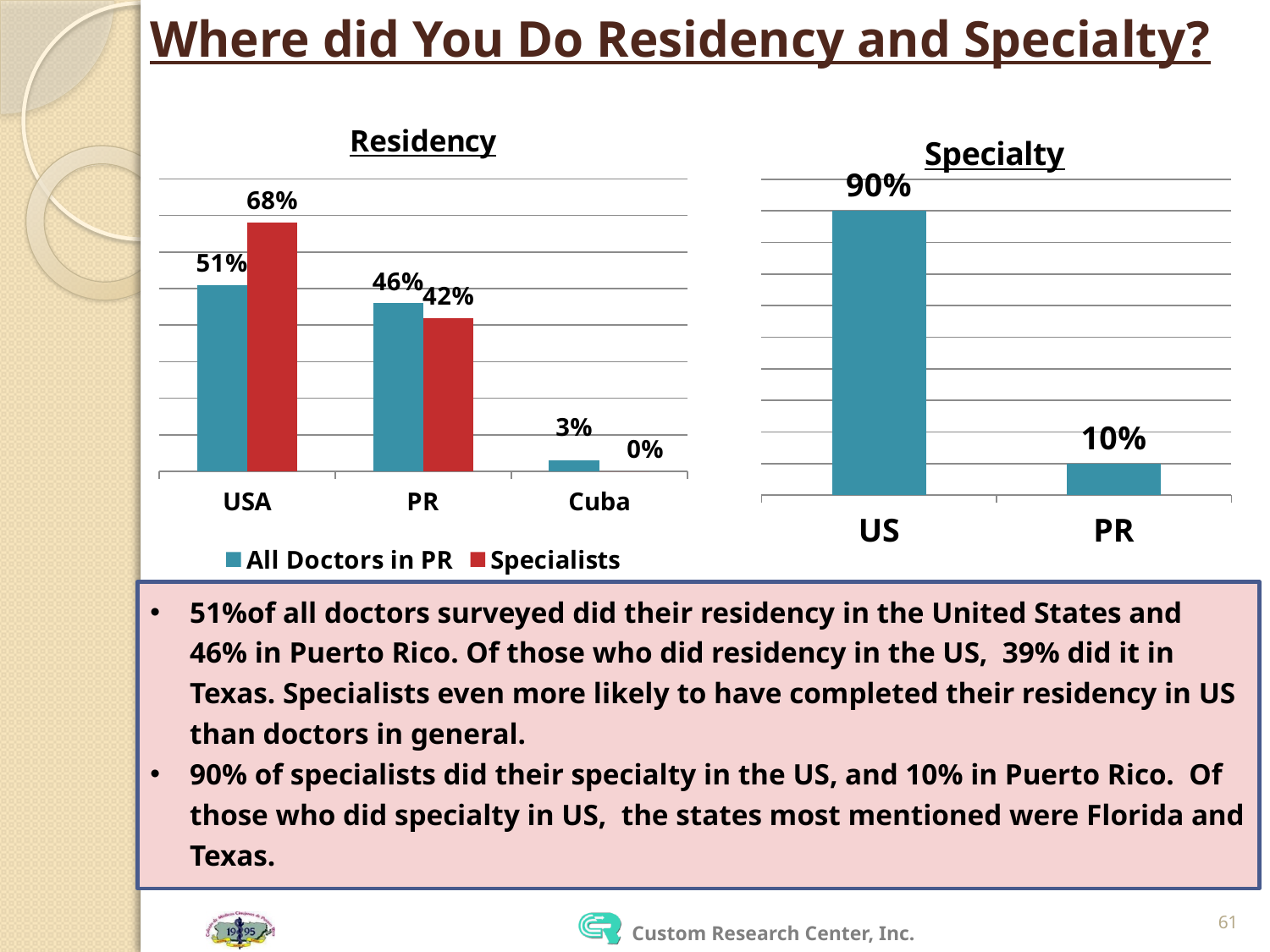
In the Residency chart, what is the value for Specialists in the USA? 68% In the Residency chart, what is the value for Specialists in Cuba? 0% In the Residency chart, what is the value for All Doctors in PR for PR? 46% In the Residency chart, which category has the lowest value for All Doctors in PR? Cuba In the Residency chart, what is the difference between Specialists and All Doctors in PR for the USA? 17% In the Residency chart, which series is shown in red? Specialists How many categories are shown on the x axis of the Residency chart? 3 In the Residency chart, which is larger for PR: All Doctors in PR or Specialists? All Doctors in PR In the Specialty chart, what is the difference between US and PR? 80% How many series does the legend of the Residency chart list? 2 In the Specialty chart, what is the value for US? 90% What kind of chart is the Specialty chart? Bar chart